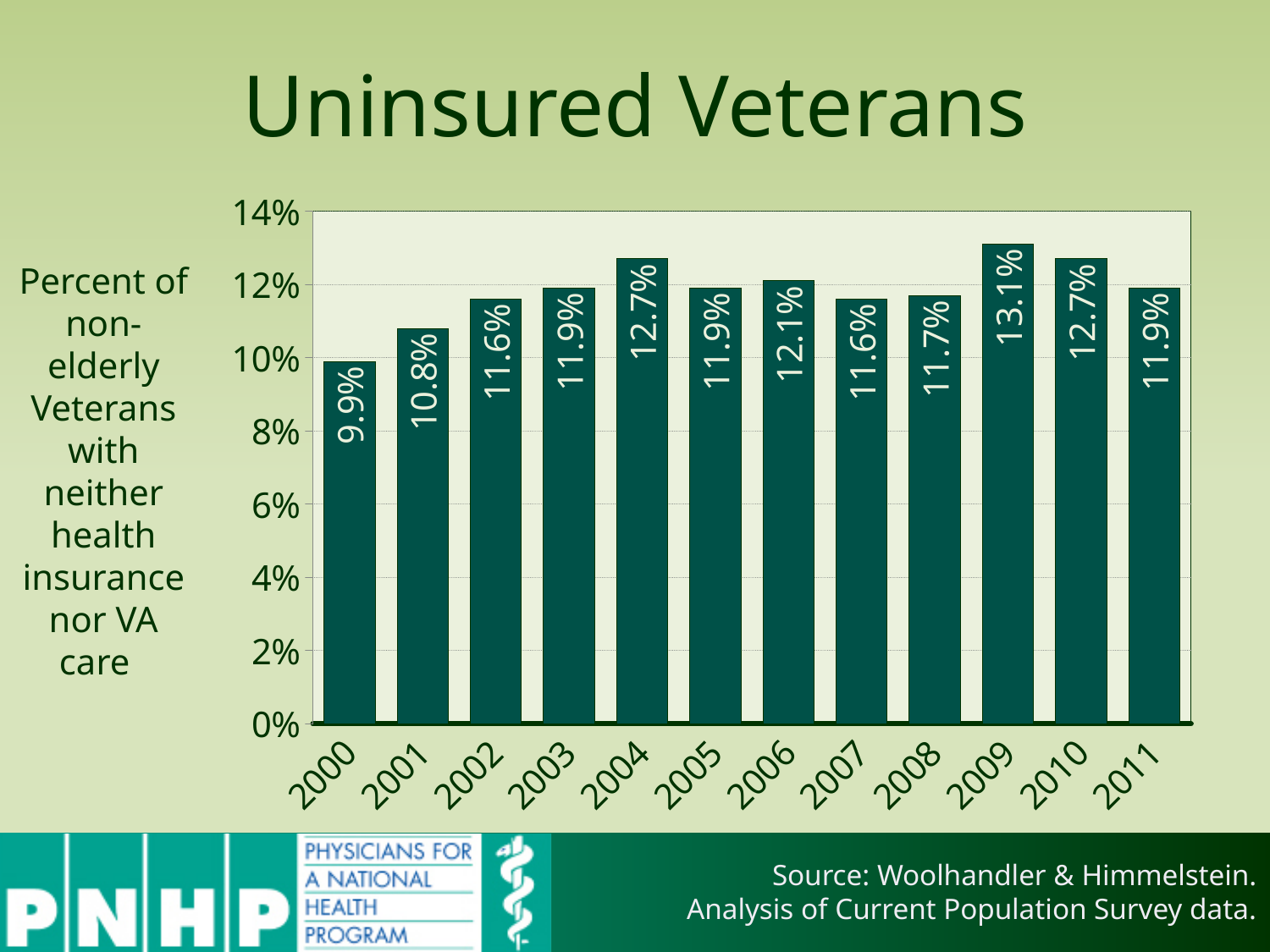
What is the value for 2009? 13.1% What is the title of the chart? Uninsured Veterans How many years are shown on the x axis? 12 Which year has the highest percentage of uninsured veterans? 2009 Is the value for 2008 greater or less than 10%? greater What is the value for 2000? 9.9% Which year has the lowest percentage of uninsured veterans? 2000 What is the value for 2006? 12.1% Which is larger, the value for 2004 or the value for 2005? 2004 What is the difference between the values for 2009 and 2000? 3.2% What kind of chart is shown on the slide? Bar chart Does the value rise or fall from 2000 to 2001? Rise